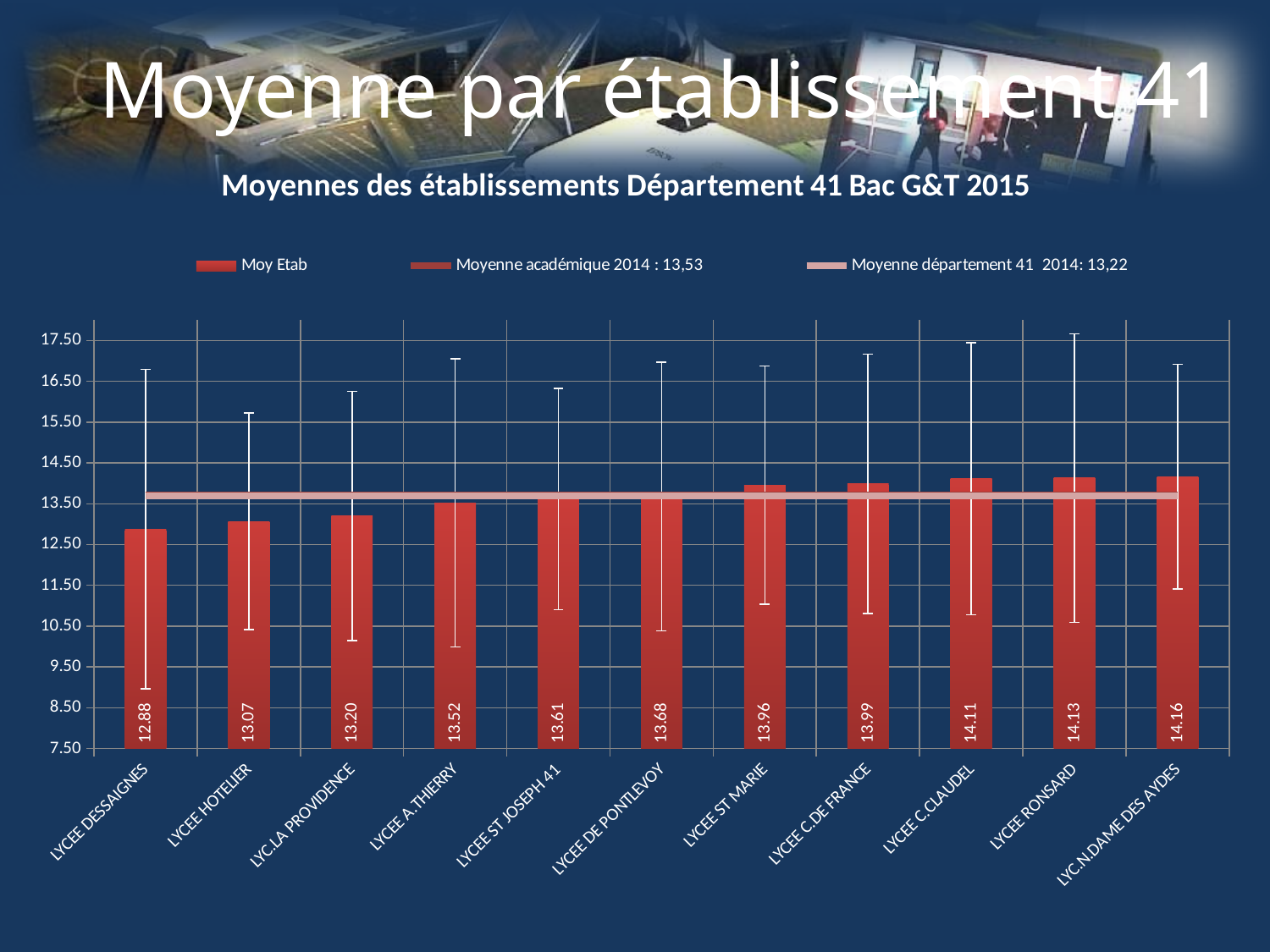
What is the value for LYCEE DESSAIGNES? 12.88 Which establishment has the lowest value? LYCEE DESSAIGNES Is the value for LYC.LA PROVIDENCE greater or less than 13.50? less What is the value for LYCEE A.THIERRY? 13.52 What is the difference between the values for LYCEE RONSARD and LYCEE HOTELIER? 1.06 How many establishments are shown on the x axis? 11 What kind of chart is shown? bar chart What is the value for LYCEE ST MARIE? 13.96 What is the title of the chart? Moyennes des établissements Département 41 Bac G&T 2015 Which is larger, the value for LYCEE C.CLAUDEL or the value for LYCEE DE PONTLEVOY? LYCEE C.CLAUDEL Which establishment has the highest value? LYC.N.DAME DES AYDES How many entries does the legend list? 3